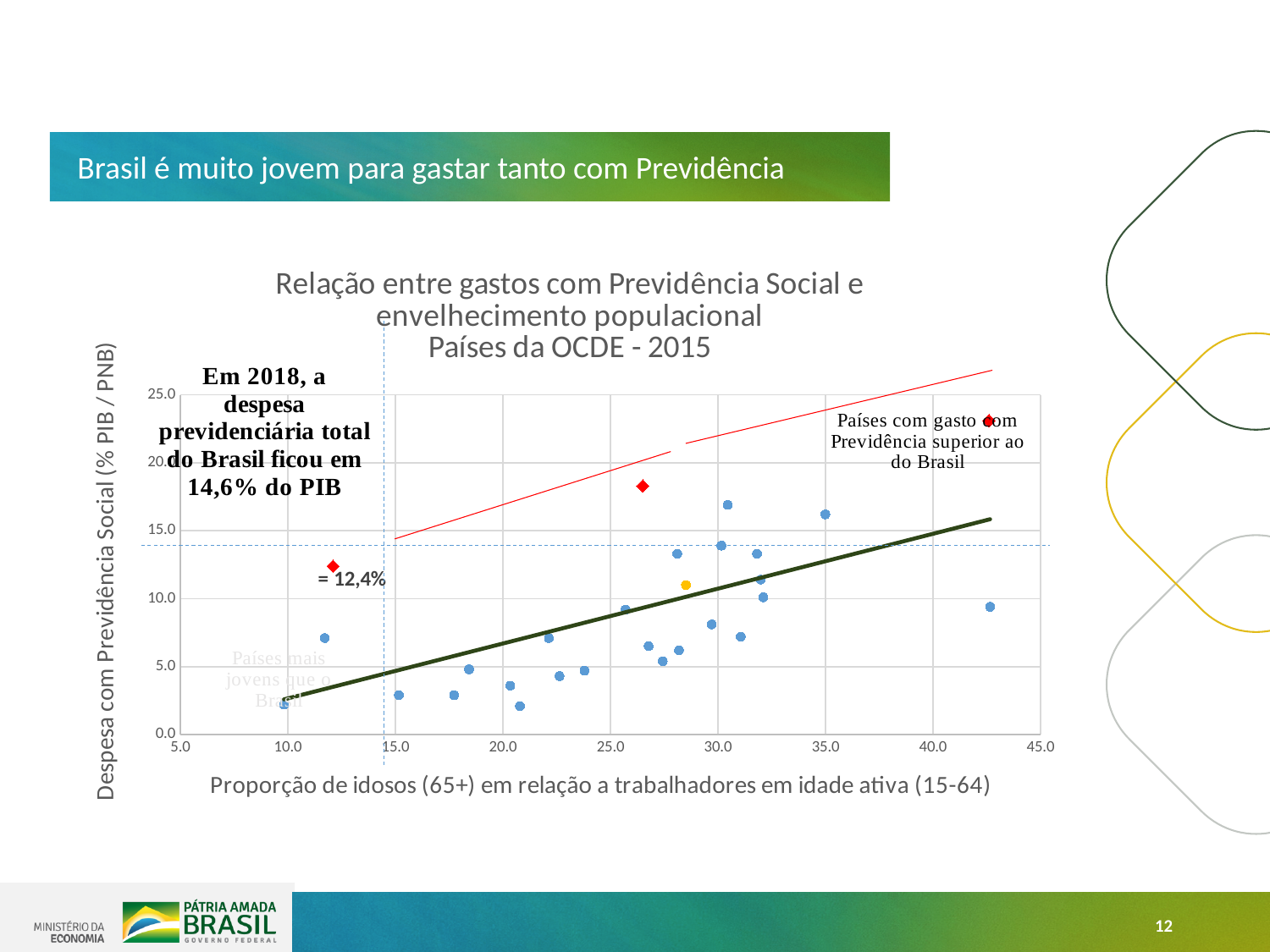
Is the value for the rightmost blue point (at about 42.5 on the x axis) greater or less than 10.0? less Is the value for the red diamond at about 42.5 on the x axis greater or less than 20.0? greater What is the label of the x axis? Proporção de idosos (65+) em relação a trabalhadores em idade ativa (15-64) Is the value for the red diamond at about 26.5 on the x axis greater or less than 15.0? greater What is the title of the chart? Relação entre gastos com Previdência Social e envelhecimento populacional Países da OCDE - 2015 Do the plotted values generally rise or fall as the proportion of elderly on the x axis increases? rise What kind of chart is shown on the slide? scatter chart Is the point with the highest y value on the chart a red diamond or a blue circle? red diamond How many red diamond markers are plotted on the chart? 3 What value is printed next to the red diamond marker at about 12 on the x axis? 12,4% According to the text box on the chart, what was Brazil's total pension expenditure in 2018 as a share of GDP? 14,6% do PIB